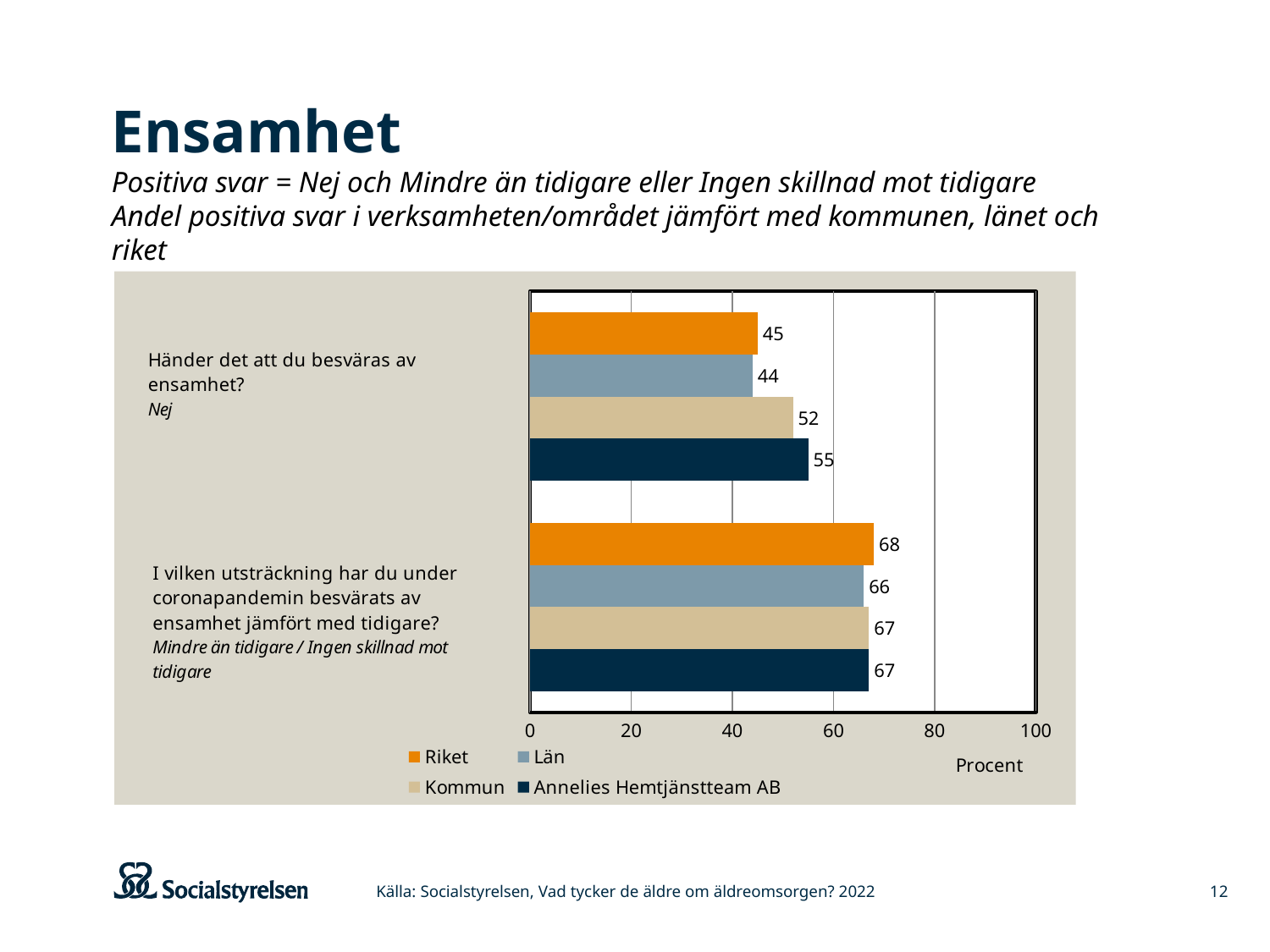
How many question categories are shown on the chart? 2 For the question 'I vilken utsträckning har du under coronapandemin besvärats av ensamhet jämfört med tidigare?', which is larger: Riket or Kommun? Riket What unit is shown on the horizontal axis of the chart? Procent How many series does the legend list? 4 What is the difference between the Annelies Hemtjänstteam AB value and the Riket value for the question 'Händer det att du besväras av ensamhet?' 10 Which series has the highest value for the question 'Händer det att du besväras av ensamhet?' Annelies Hemtjänstteam AB What is the value for Kommun for the question 'Händer det att du besväras av ensamhet?' 52 What is the value for Län for the question 'I vilken utsträckning har du under coronapandemin besvärats av ensamhet jämfört med tidigare?' 66 What is the value for Riket for the question 'Händer det att du besväras av ensamhet?' 45 What is the value for Annelies Hemtjänstteam AB for the question 'Händer det att du besväras av ensamhet?' 55 Which series has the lowest value for the question 'I vilken utsträckning har du under coronapandemin besvärats av ensamhet jämfört med tidigare?' Län What kind of chart is shown on the slide? Bar chart